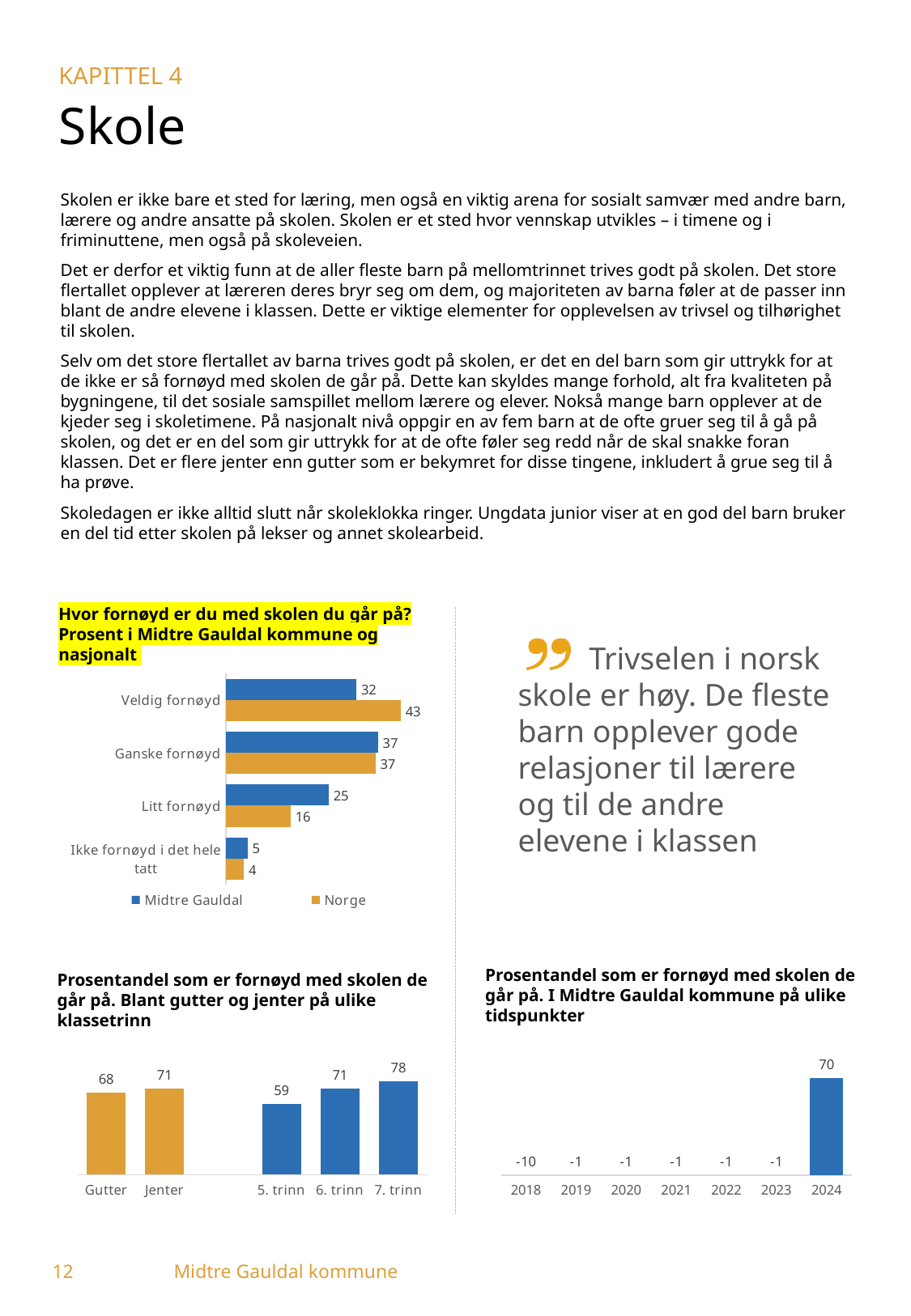
In the chart 'Hvor fornøyd er du med skolen du går på?', which series is shown in orange? Norge In the chart 'Prosentandel som er fornøyd med skolen de går på. Blant gutter og jenter på ulike klassetrinn', which is larger, Gutter or Jenter? Jenter In the chart 'Hvor fornøyd er du med skolen du går på?', what is the value for Midtre Gauldal in the 'Veldig fornøyd' category? 32 What kind of chart is 'Prosentandel som er fornøyd med skolen de går på. Blant gutter og jenter på ulike klassetrinn'? bar chart In the chart 'Prosentandel som er fornøyd med skolen de går på. Blant gutter og jenter på ulike klassetrinn', do the values rise or fall from 5. trinn to 7. trinn? rise In the chart 'Hvor fornøyd er du med skolen du går på?', how many series does the legend list? 2 In the chart 'Hvor fornøyd er du med skolen du går på?', what is the value for Norge in the 'Litt fornøyd' category? 16 In the chart 'Prosentandel som er fornøyd med skolen de går på. Blant gutter og jenter på ulike klassetrinn', which category has the highest value? 7. trinn In the chart 'Hvor fornøyd er du med skolen du går på?', what is the difference between Norge and Midtre Gauldal for 'Veldig fornøyd'? 11 In the chart 'Hvor fornøyd er du med skolen du går på?', which category has the lowest value for Midtre Gauldal? Ikke fornøyd i det hele tatt In the chart 'Prosentandel som er fornøyd med skolen de går på. Blant gutter og jenter på ulike klassetrinn', what is the value for 5. trinn? 59 In the chart 'Prosentandel som er fornøyd med skolen de går på. I Midtre Gauldal kommune på ulike tidspunkter', what is the value for 2024? 70